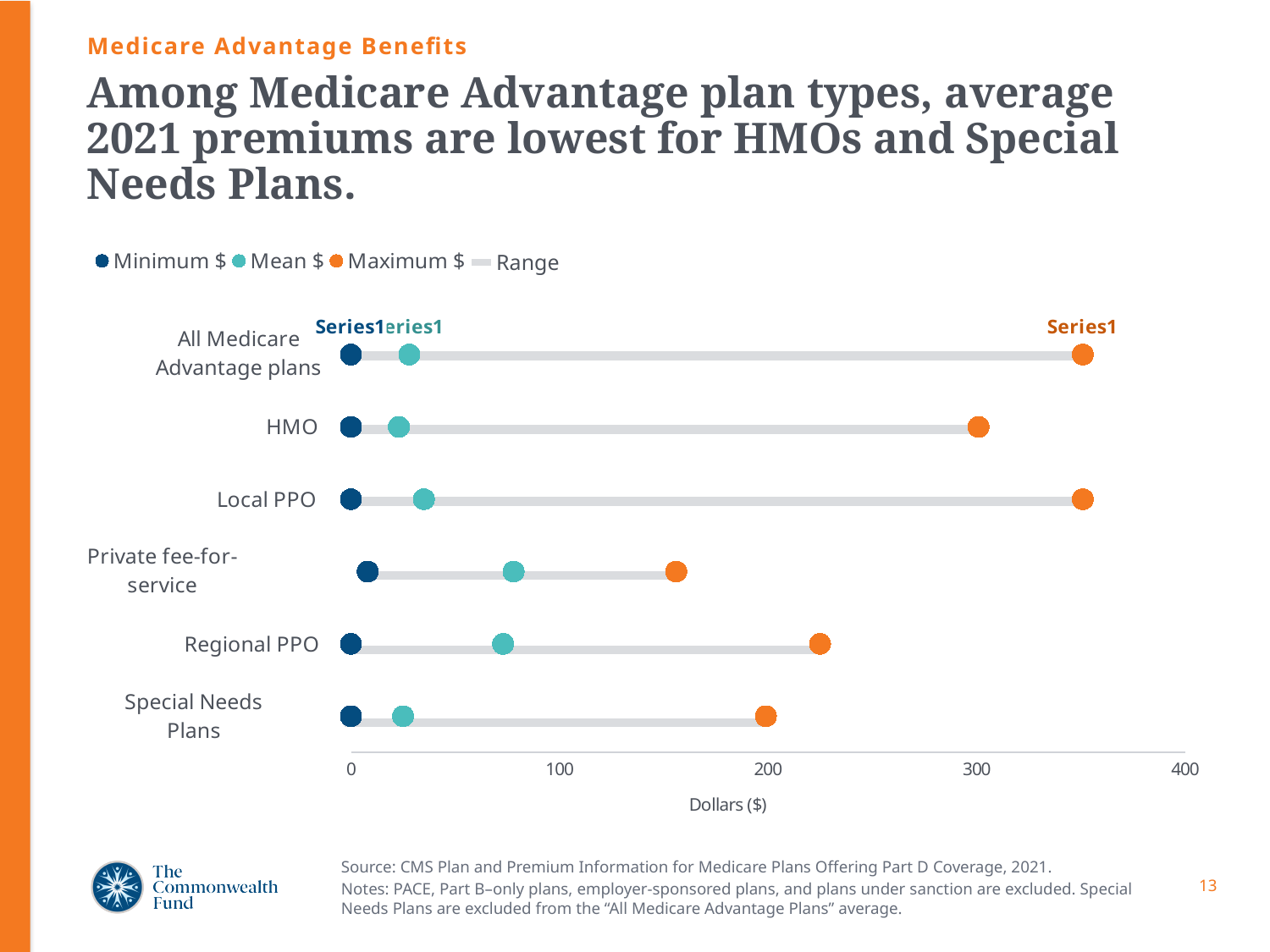
Which colour marks the Maximum $ values in the chart? Orange Is the Maximum $ value for Private fee-for-service greater or less than 200? less How many entries does the chart legend list? 4 Is the Mean $ value for Regional PPO greater or less than 100? less How many plan type categories are shown on the chart? 6 Is the Maximum $ value for All Medicare Advantage plans greater or less than 300? greater Which has the larger Maximum $ value, Regional PPO or Private fee-for-service? Regional PPO Which has the larger Mean $ value, Local PPO or HMO? Local PPO What is the Minimum $ value for HMO? 0 What is the label on the horizontal axis of the chart? Dollars ($) Which plan type has the lowest Maximum $ value? Private fee-for-service